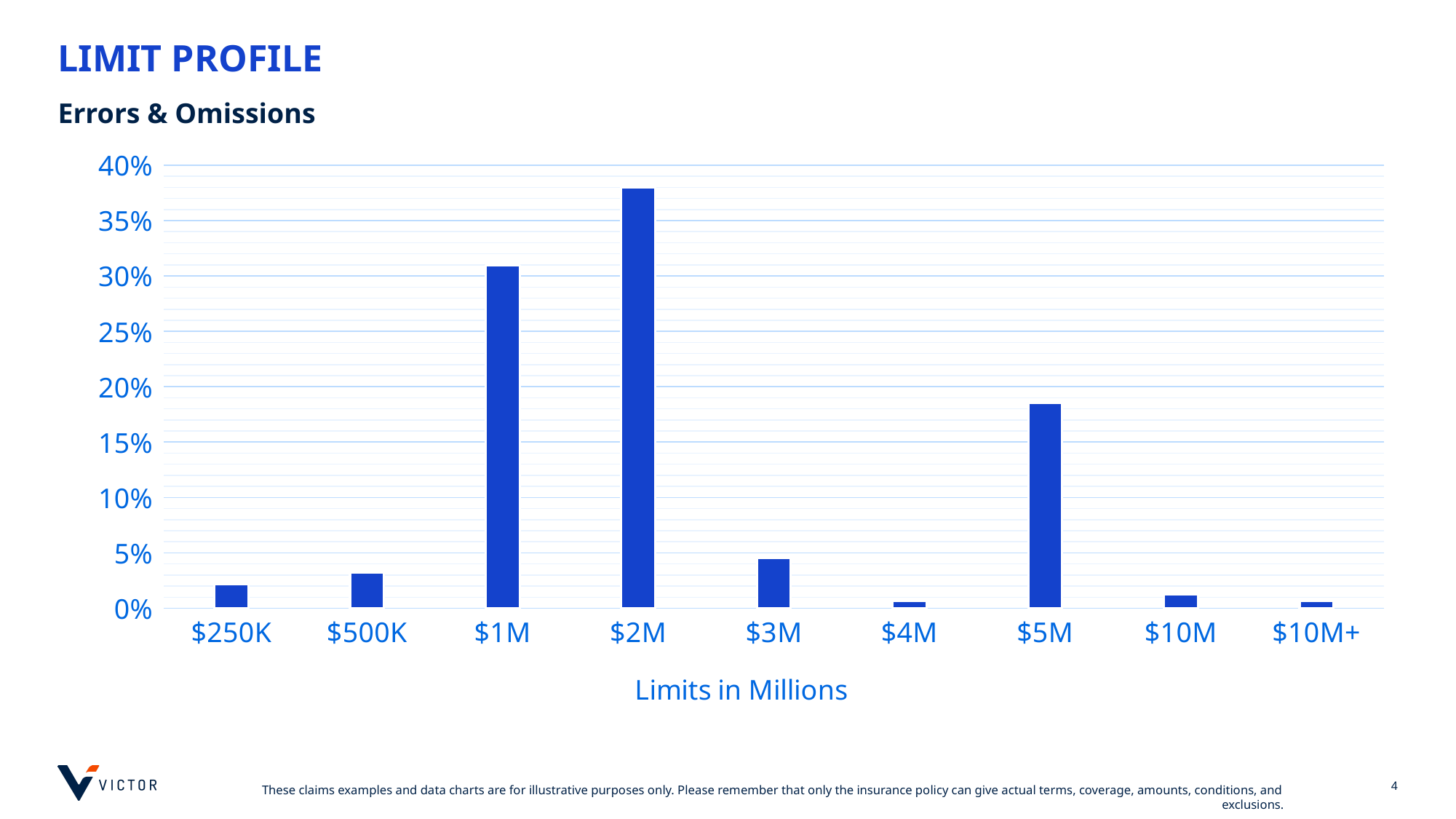
What line of business does the chart's subtitle say the limit profile is for? Errors & Omissions What kind of chart is shown on the slide? bar chart Is the value for $2M greater or less than 35%? greater Which is larger, the value for $1M or the value for $5M? $1M What is the title of the x axis? Limits in Millions Is the value for $1M greater or less than 25%? greater Is the value for $250K greater or less than 5%? less Which limit category has the highest value? $2M How many limit categories are shown on the x axis? 9 Which is larger, the value for $3M or the value for $10M? $3M